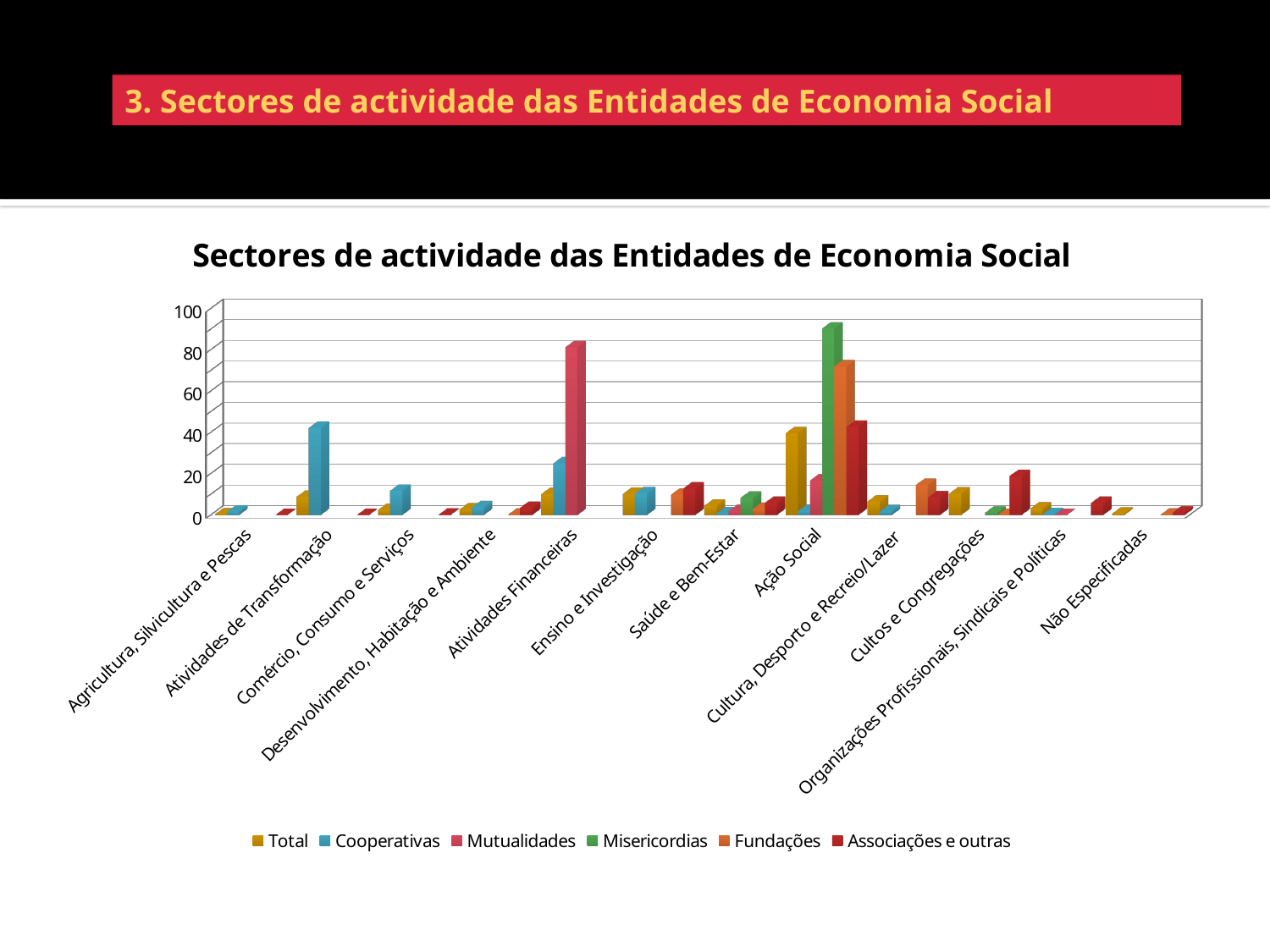
Is the value for Cooperativas in Atividades Financeiras greater or less than 40? less Which series is listed first in the legend? Total In the Ação Social category, which series has the tallest bar? Misericordias Is the value for Fundações in Ação Social greater or less than 60? greater How many series does the legend list? 6 In the Atividades Financeiras category, which series has the tallest bar? Mutualidades In Ação Social, which is larger: the Misericordias bar or the Fundações bar? Misericordias What is the title of the chart? Sectores de actividade das Entidades de Economia Social What kind of chart is shown on the slide? bar chart Is the value for Misericordias in Ação Social greater or less than 80? greater In the Atividades de Transformação category, which series has the tallest bar? Cooperativas How many sector categories are shown along the x axis? 12